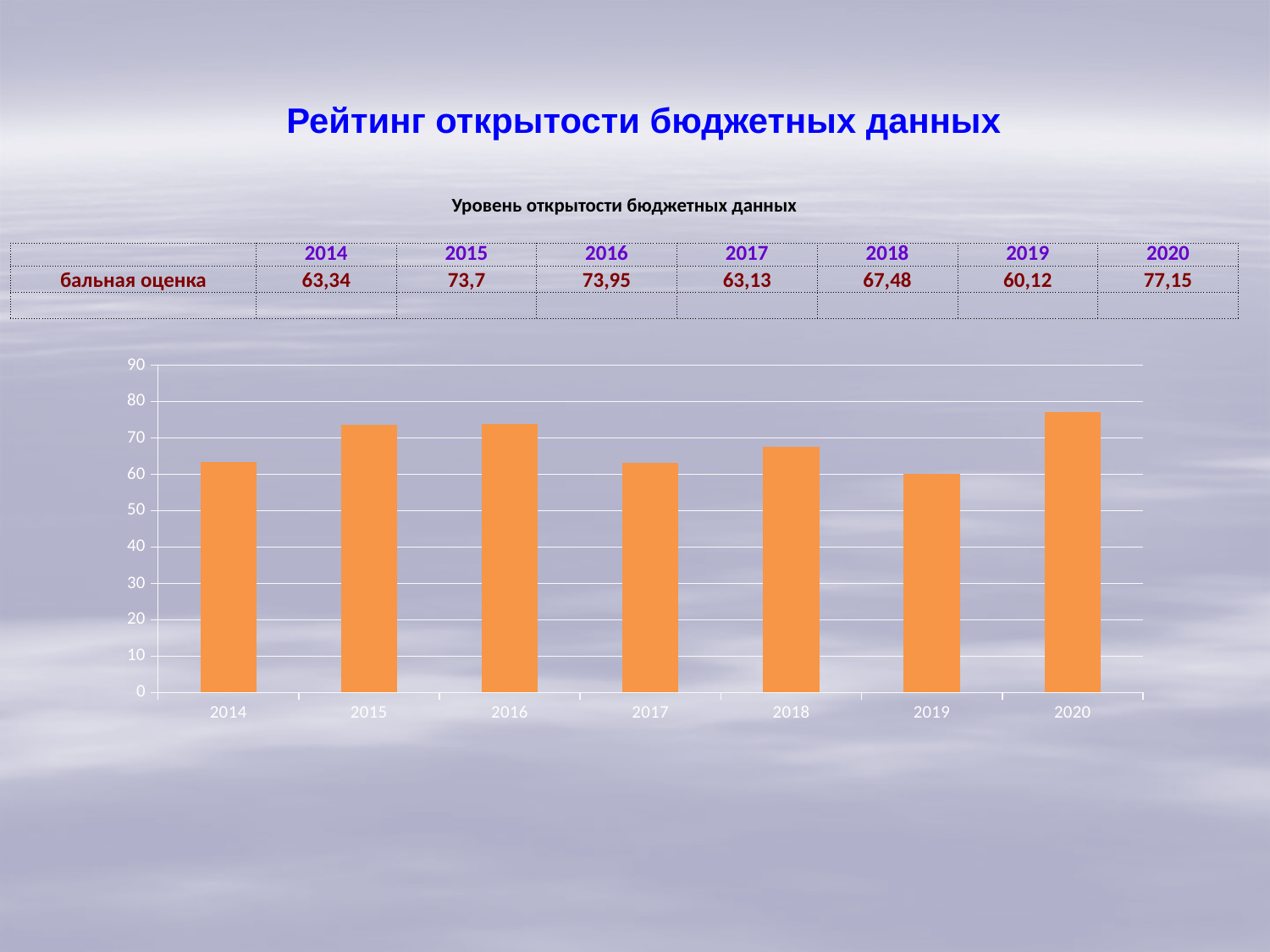
How many years are shown on the x axis? 7 Which year has the lowest value? 2019 What is the value for 2020? 77,15 What is the value for 2014? 63,34 What is the value for 2018? 67,48 What kind of chart is shown? bar chart Which is larger, the value for 2015 or the value for 2014? 2015 What is the difference between the values for 2020 and 2019? 17,03 Is the value for 2020 greater or less than 70? greater What is the difference between the values for 2018 and 2017? 4,35 What is the title of the chart? Уровень открытости бюджетных данных Which year has the highest value? 2020